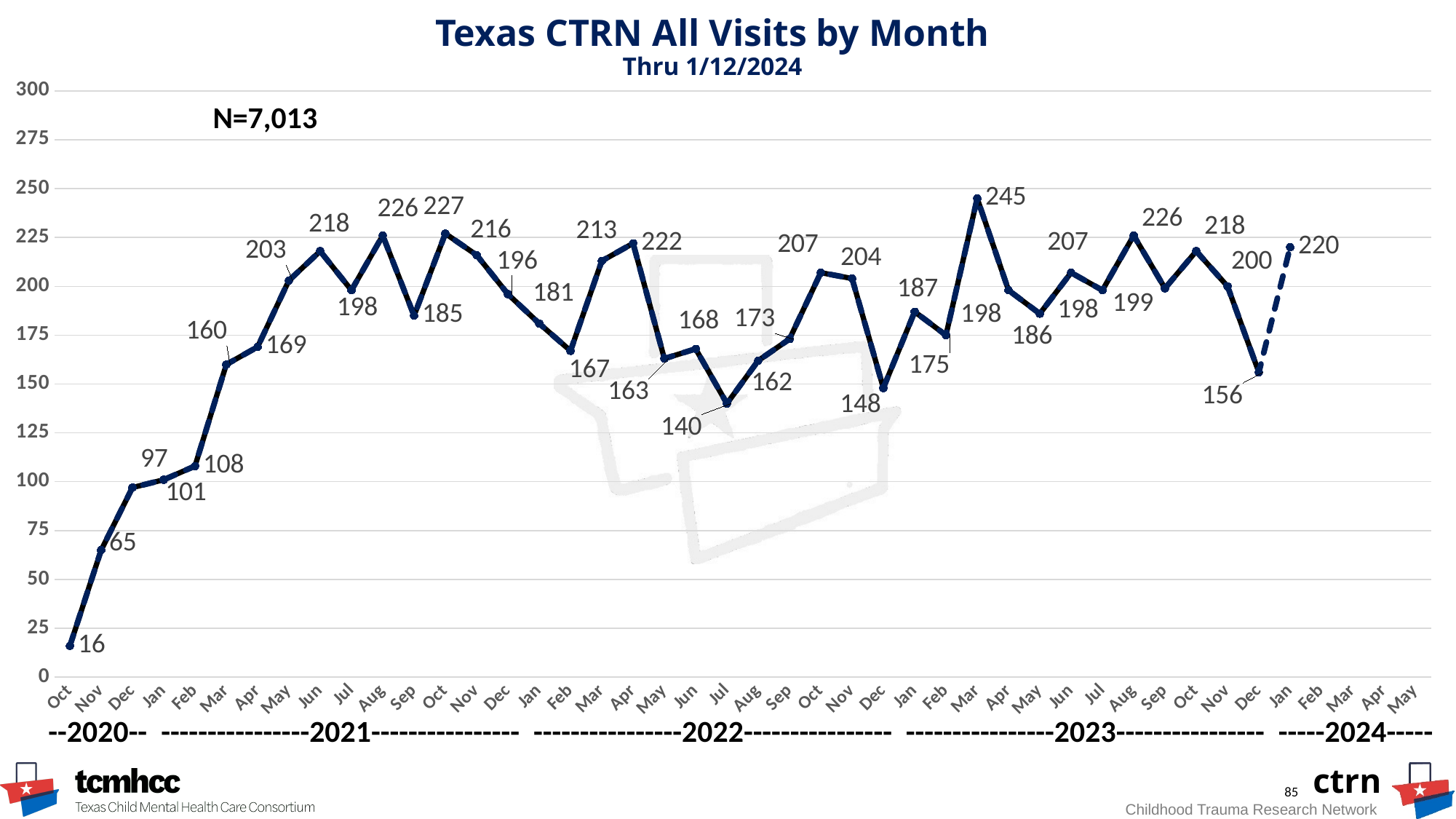
What is the value for Jan 2024? 220 Which is larger, the value for Mar 2022 or the value for Apr 2022? Apr 2022 Which month has the lowest number of visits? Oct 2020 Do the values rise or fall from Oct 2020 to Jun 2021? rise What N value is printed on the chart? N=7,013 What is the difference between the values for Mar 2023 and Feb 2023? 70 What is the value for Oct 2020? 16 What is the value for Mar 2023? 245 What is the value for Jul 2022? 140 What kind of chart is shown on the slide? line chart What is the difference between the values for Jan 2024 and Dec 2023? 64 Which month has the highest number of visits? Mar 2023